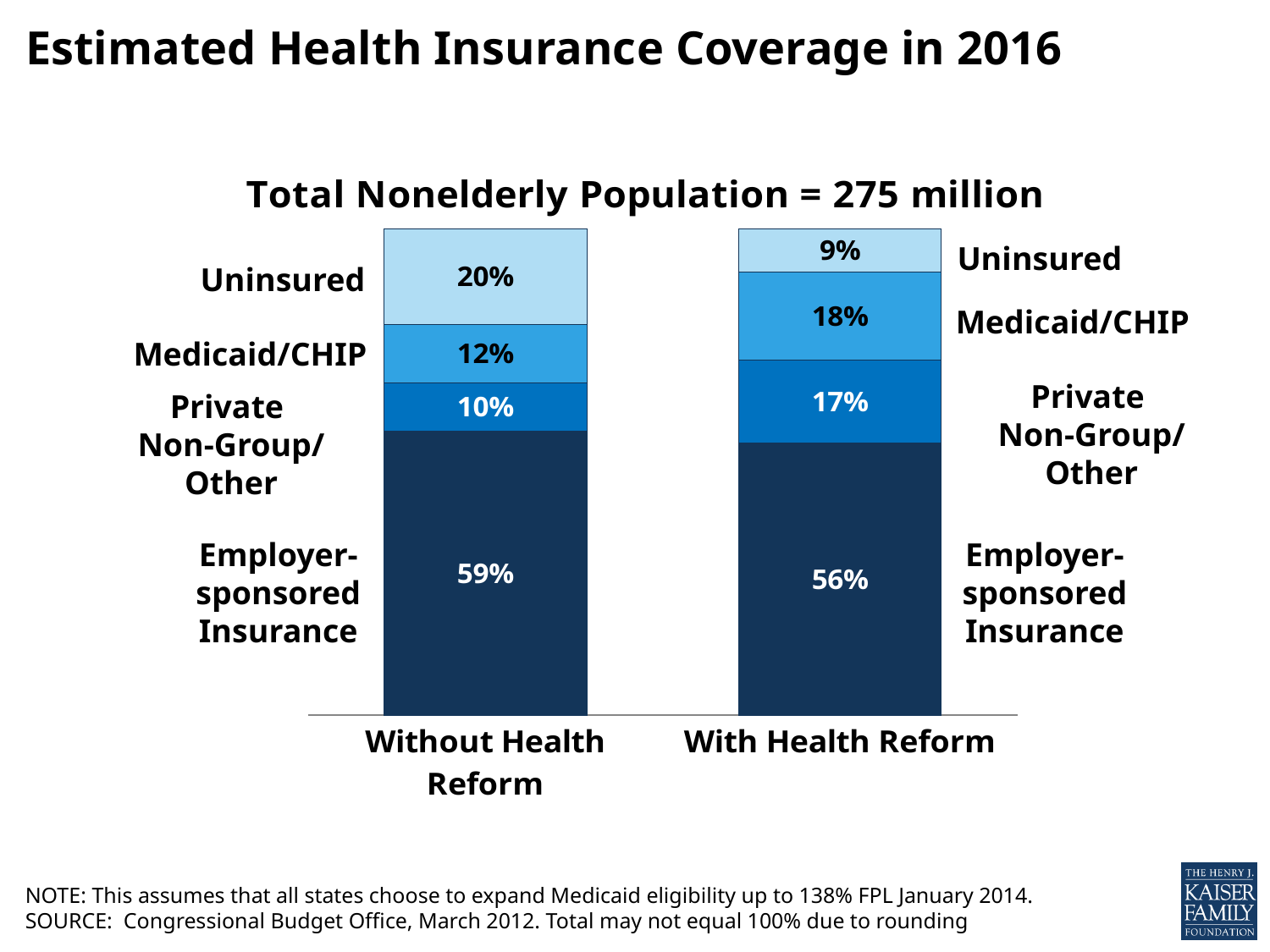
What is the Medicaid/CHIP share with health reform? 18% How many bars are shown in the chart? 2 What share of the nonelderly population is Uninsured without health reform? 20% Which coverage category has the largest share in the With Health Reform bar? Employer-sponsored Insurance Is the Medicaid/CHIP share larger without health reform or with health reform? With Health Reform What share of the nonelderly population is Uninsured with health reform? 9% What kind of chart is shown on the slide? Stacked bar chart Which coverage category has the smallest share in the Without Health Reform bar? Private Non-Group/Other What is the Employer-sponsored Insurance share without health reform? 59% By how many percentage points does the Uninsured share fall from Without Health Reform to With Health Reform? 11 percentage points What is the Private Non-Group/Other share with health reform? 17% What total nonelderly population does the chart subtitle state? 275 million